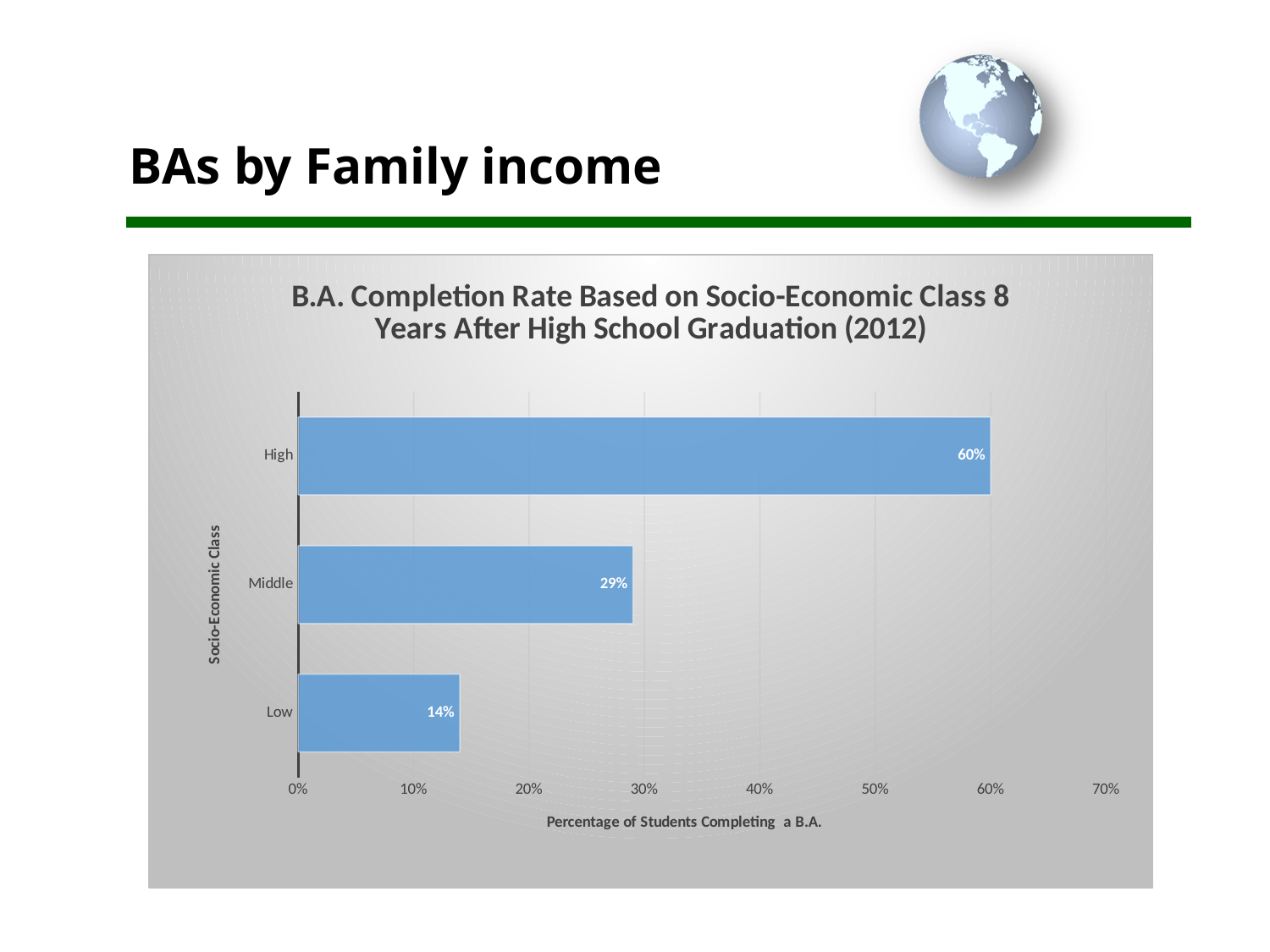
Which has a higher B.A. completion rate, the Middle or the Low socio-economic class? Middle What is the B.A. completion rate for the Middle socio-economic class? 29% What is the difference in B.A. completion rate between the High and Low socio-economic classes? 46% What is the label of the horizontal axis of the chart? Percentage of Students Completing a B.A. What type of chart is used to show the B.A. completion rates? Bar chart What is the B.A. completion rate for the High socio-economic class? 60% Which socio-economic class has the highest B.A. completion rate? High What is the B.A. completion rate for the Low socio-economic class? 14% How many socio-economic classes are shown in the chart? 3 Which socio-economic class has the lowest B.A. completion rate? Low Is the B.A. completion rate for the Middle socio-economic class greater or less than 30%? less What is the difference in B.A. completion rate between the Middle and Low socio-economic classes? 15%